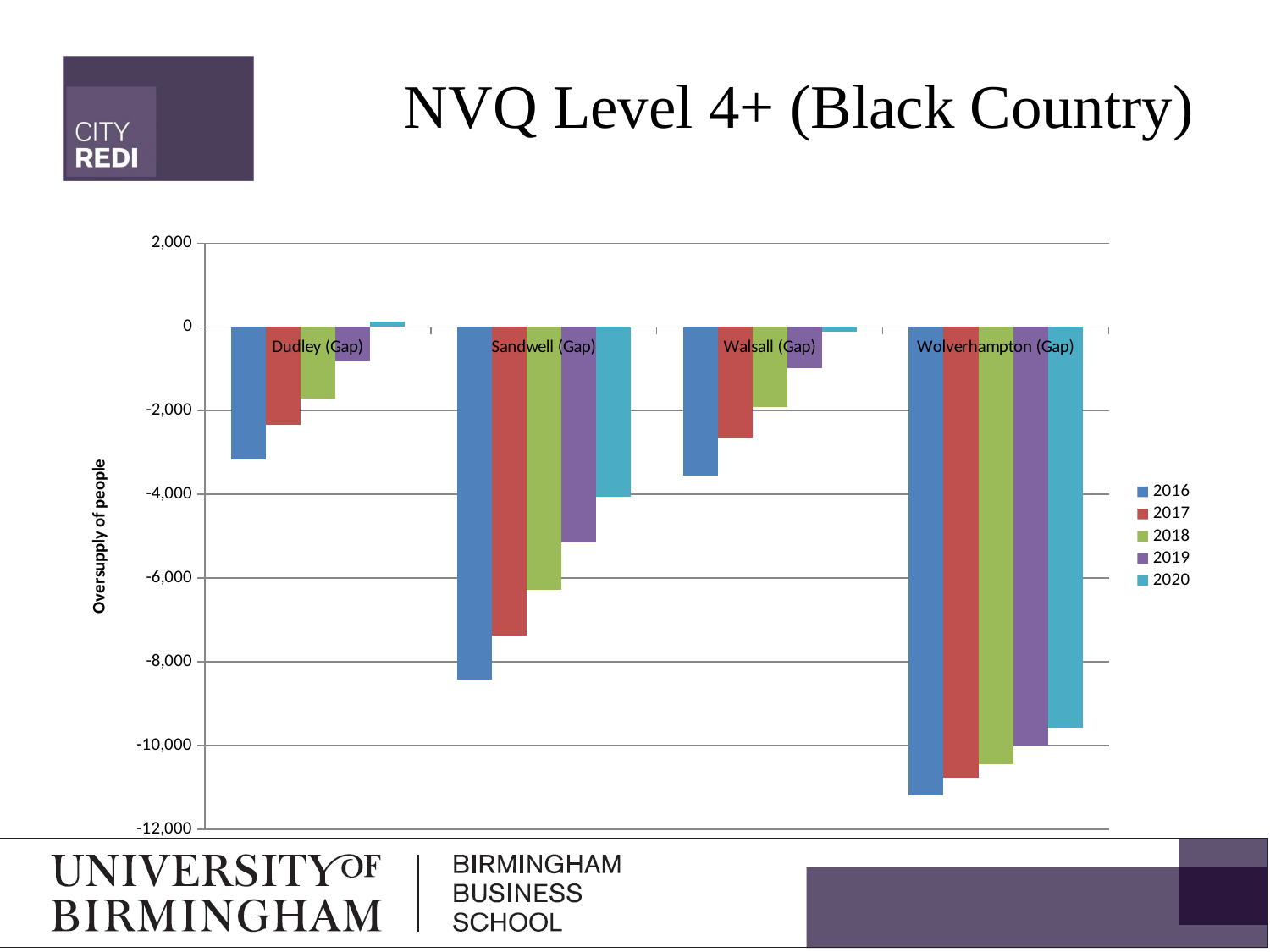
Which category has the lowest 2016 value? Wolverhampton (Gap) What is the title of the chart? NVQ Level 4+ (Black Country) Is the 2019 value for Sandwell (Gap) greater or less than -4,000? less Is the 2016 value for Dudley (Gap) greater or less than -4,000? greater What kind of chart is shown on the slide? Bar chart Is the 2016 value for Sandwell (Gap) greater or less than -8,000? less What is the label on the vertical axis? Oversupply of people Which is larger, the 2016 value for Sandwell (Gap) or the 2016 value for Walsall (Gap)? Walsall (Gap) For Sandwell (Gap), do the values rise or fall from 2016 to 2020? rise How many series does the legend list? 5 How many categories are shown on the x axis of the chart? 4